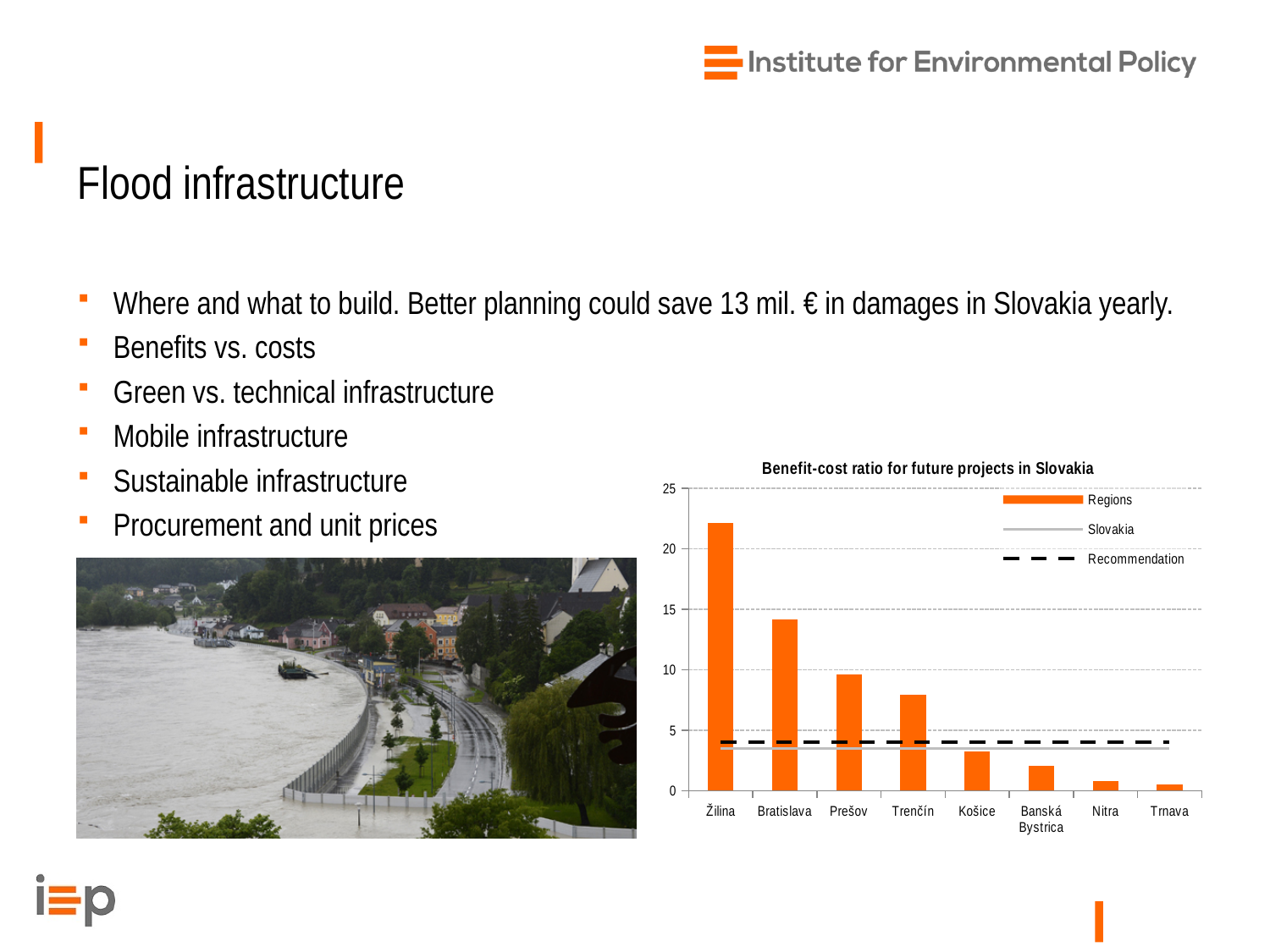
Is the benefit-cost ratio for Žilina greater or less than 20? greater What type of chart is shown on the slide? bar chart Which has a higher benefit-cost ratio, Prešov or Košice? Prešov Do the bar values rise or fall from left to right along the x axis? fall Which region has the highest benefit-cost ratio? Žilina Which legend entry is shown as a dashed black line? Recommendation Is the benefit-cost ratio for Košice greater or less than 5? less What is the title of the chart? Benefit-cost ratio for future projects in Slovakia How many entries does the chart's legend list? 3 Is the benefit-cost ratio for Trenčín greater or less than 5? greater How many regions are shown on the x axis of the chart? 8